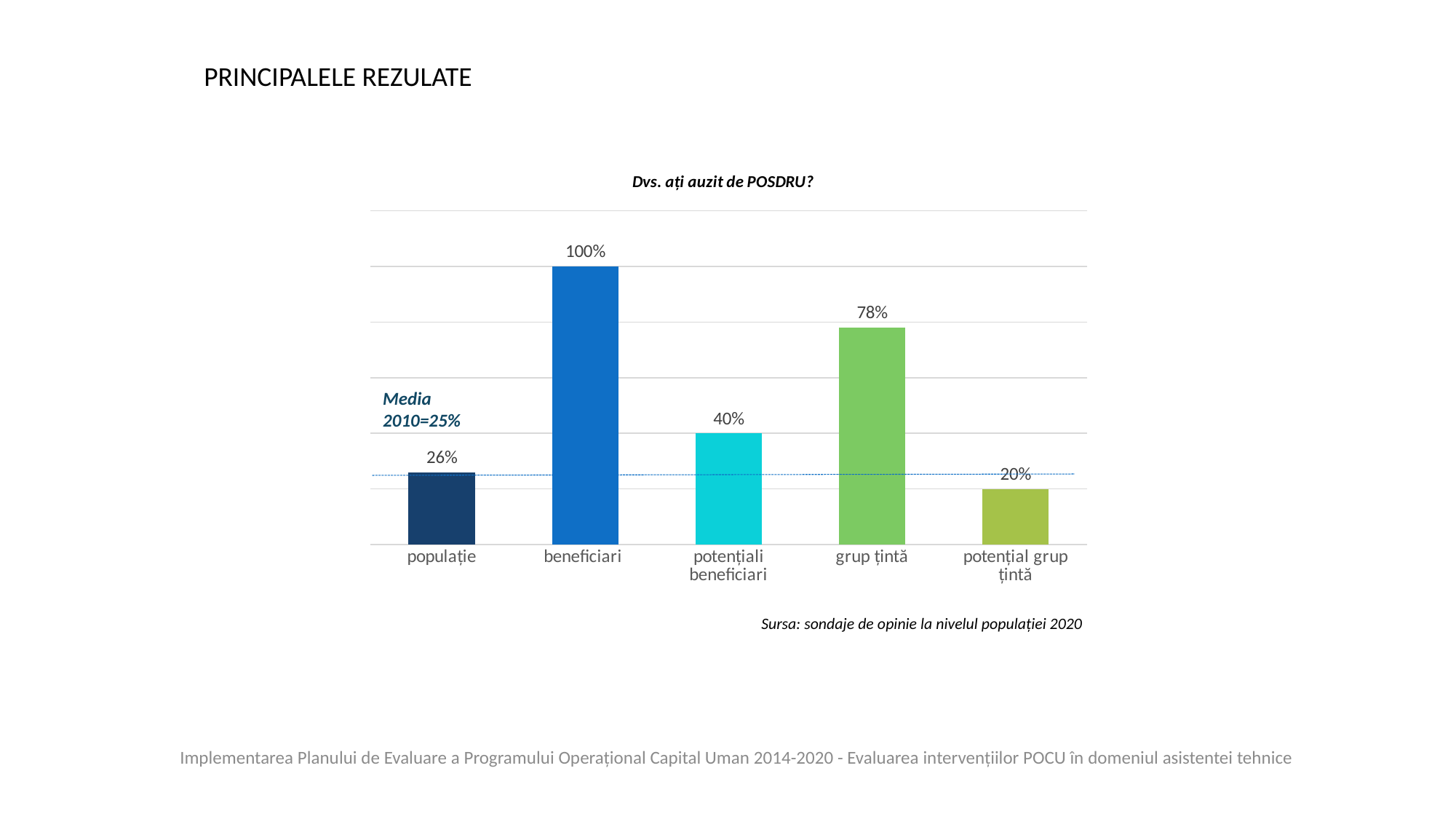
What is the value for potențial grup țintă? 20% What is the value for grup țintă? 78% Which is larger, the value for potențiali beneficiari or the value for grup țintă? grup țintă What kind of chart is shown on the slide? bar chart What is the title of the chart? Dvs. ați auzit de POSDRU? What is the difference between the values for beneficiari and grup țintă? 22% Which category has the highest value? beneficiari What is the difference between the values for potențiali beneficiari and populație? 14% Which category has the lowest value? potențial grup țintă How many categories are shown in the chart? 5 What is the value for populație? 26% What is the value for beneficiari? 100%